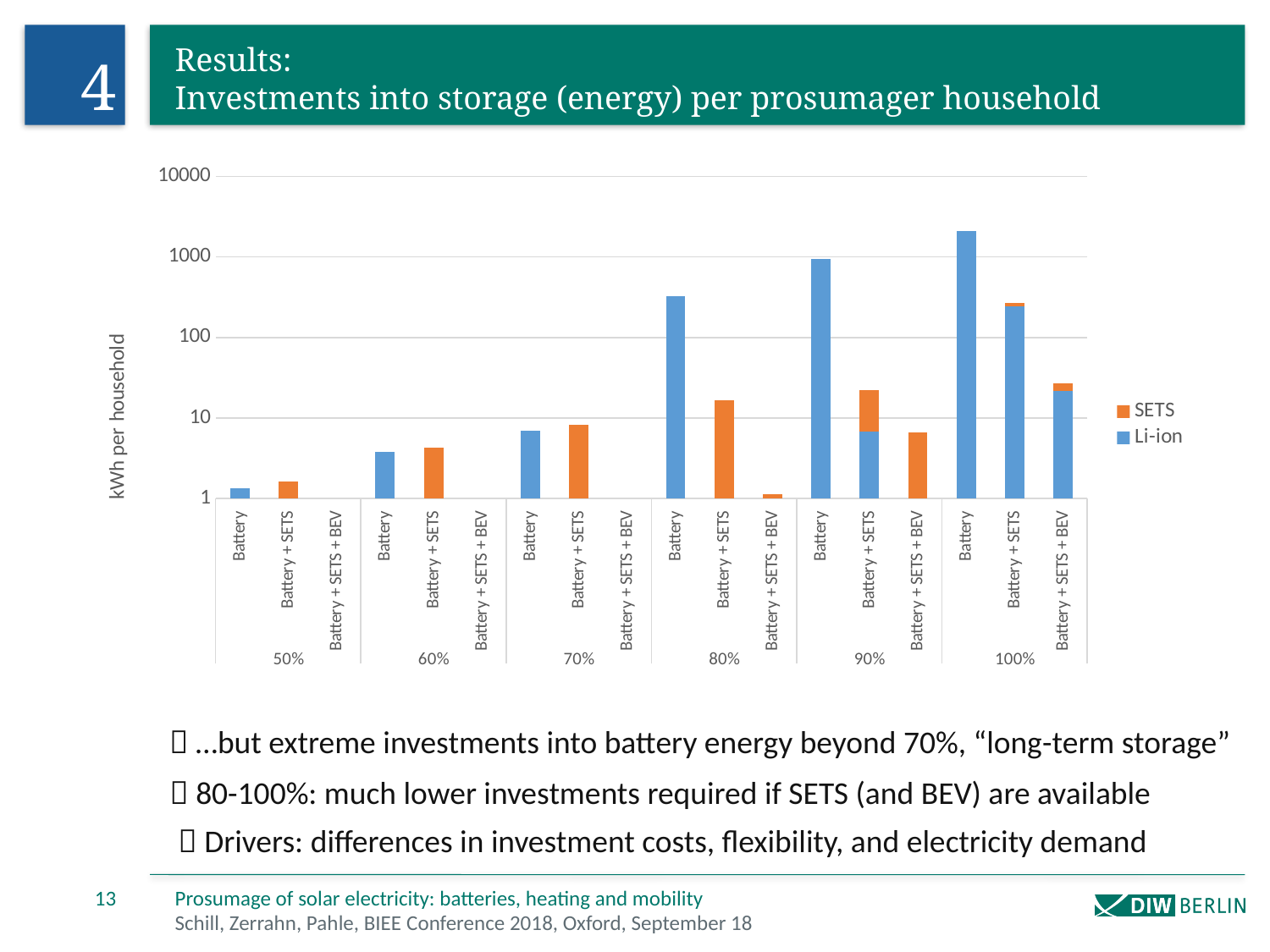
Do the Battery-only bars rise or fall as the percentage increases from 50% to 100%? rise Is the value for Battery at 60% greater or less than 10? less Is the value for Battery at 80% greater or less than 100? greater What is the label of the vertical axis? kWh per household What are the two series named in the legend? SETS and Li-ion How many percentage groups are shown along the x axis? 6 How many series does the legend list? 2 Is the total for Battery + SETS at 90% greater or less than 10? greater Which bar is the tallest in the chart? Battery at 100% What type of chart is shown on the slide? Bar chart At 80%, which is larger: the Battery bar or the Battery + SETS bar? Battery